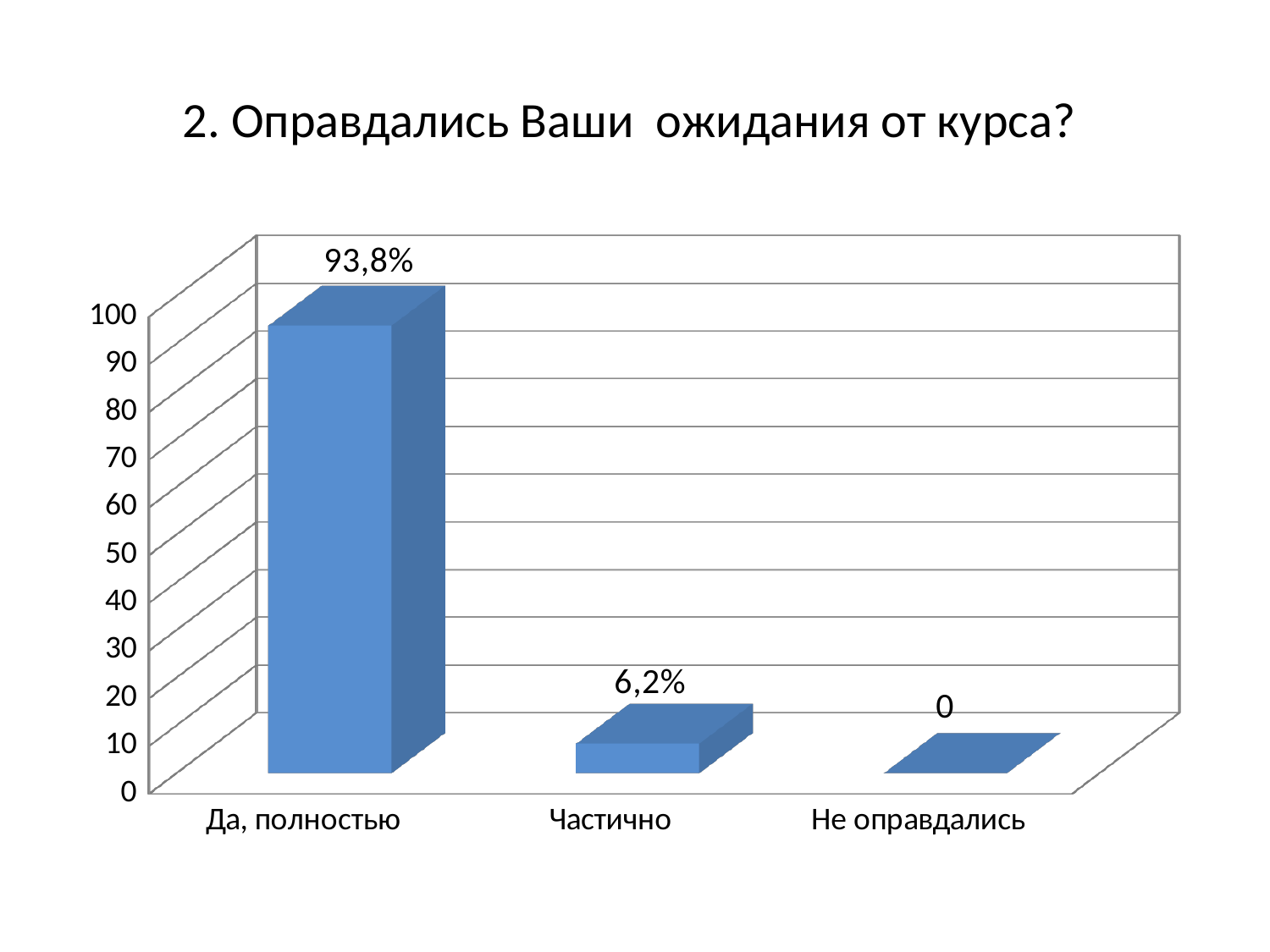
Is the value for "Частично" greater or less than 10? less What is the difference between the values for "Да, полностью" and "Частично"? 87,6% What is the value for "Частично"? 6,2% Which category has the highest value? Да, полностью What is the value for "Да, полностью"? 93,8% Is the value for "Да, полностью" greater or less than 90? greater What is the value for "Не оправдались"? 0 What is the title of the slide? 2. Оправдались Ваши ожидания от курса? Which category has the lowest value? Не оправдались How many categories are shown on the chart? 3 Which is larger, the value for "Частично" or the value for "Не оправдались"? Частично What kind of chart is shown on the slide? bar chart